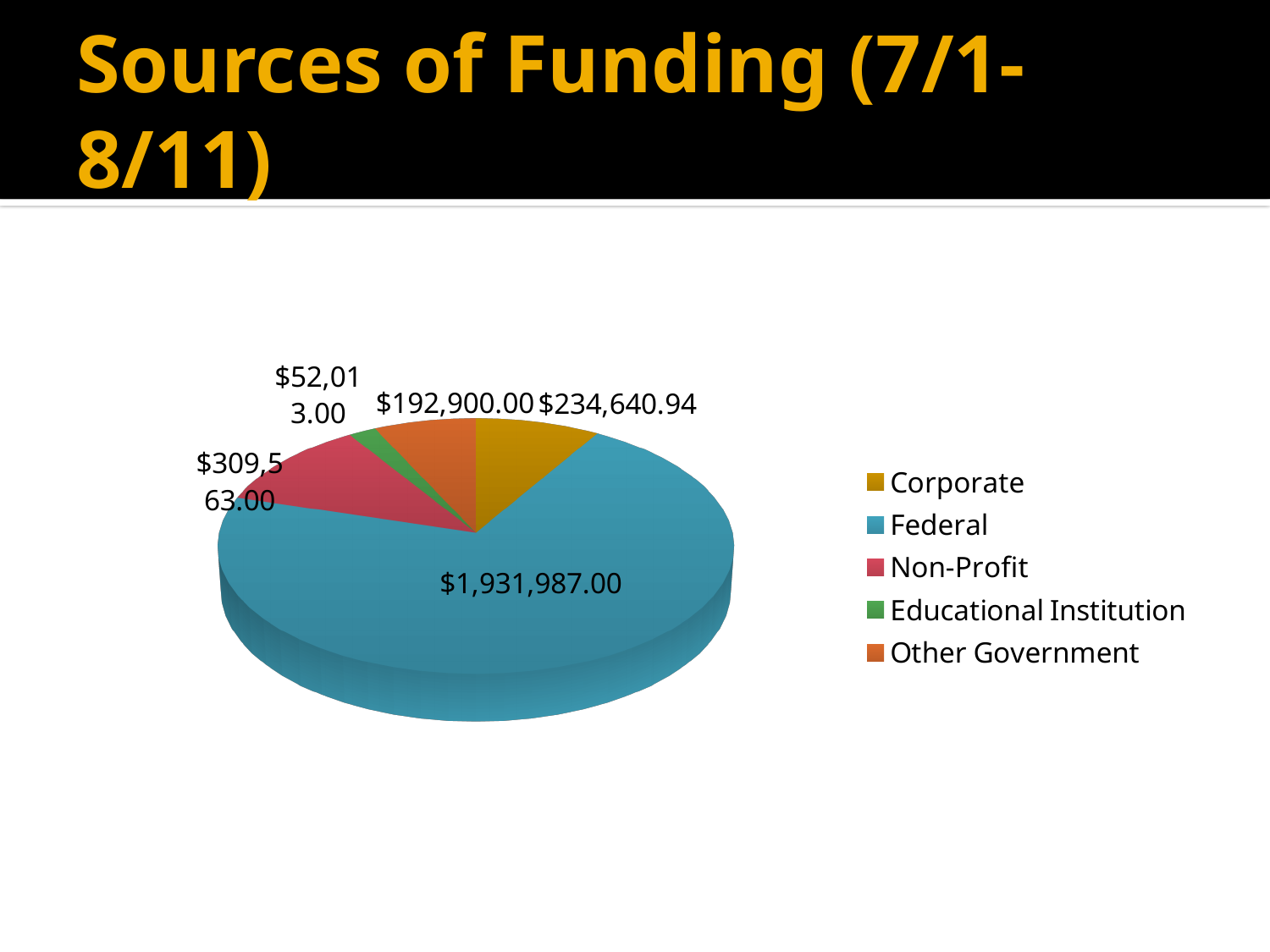
What is the difference between the Federal and Non-Profit values? $1,622,424.00 What is the value of the Educational Institution slice? $52,013.00 Which funding source has the smallest slice? Educational Institution What type of chart is shown on the slide? pie chart What is the value of the Corporate slice? $234,640.94 How many funding sources are shown in the pie chart? 5 What is the value of the Non-Profit slice? $309,563.00 What is the title of the chart slide? Sources of Funding (7/1-8/11) Which funding source has the largest slice? Federal What is the value of the Federal slice? $1,931,987.00 Which is larger, the Non-Profit slice or the Corporate slice? Non-Profit What is the value of the Other Government slice? $192,900.00